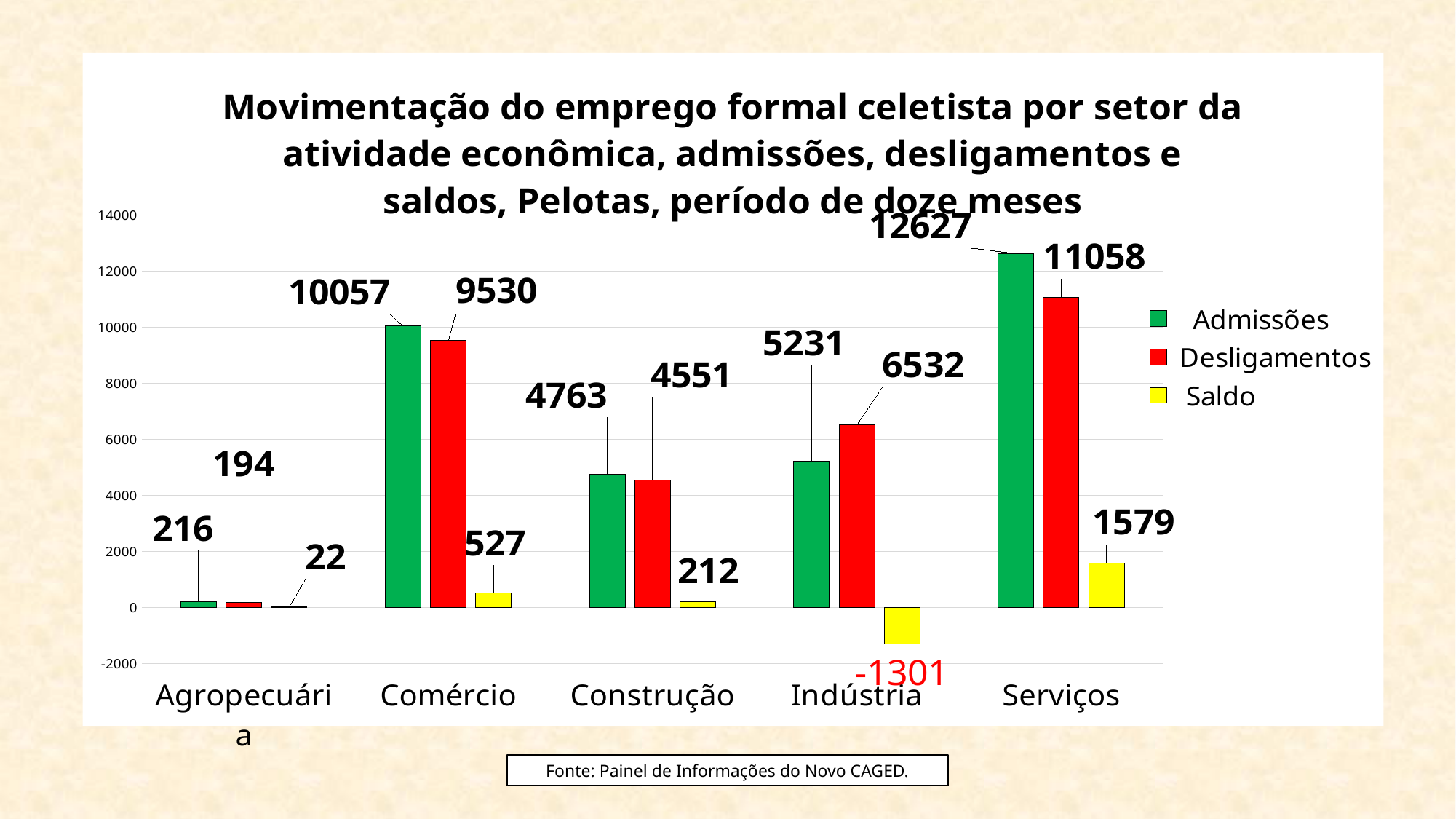
Is the Admissões value for Construção greater or less than 4000? greater What is the Saldo value for Serviços? 1579 Which sector has the highest Admissões value? Serviços What is the Desligamentos value for Indústria? 6532 Which sector has the lowest Desligamentos value? Agropecuária What is the Admissões value for Comércio? 10057 What is the difference between Admissões and Desligamentos for Serviços? 1569 What kind of chart is shown on the slide? Bar chart For Indústria, which is larger: Admissões or Desligamentos? Desligamentos What is the Saldo value for Indústria? -1301 How many sectors are shown on the x axis? 5 How many series does the legend list? 3